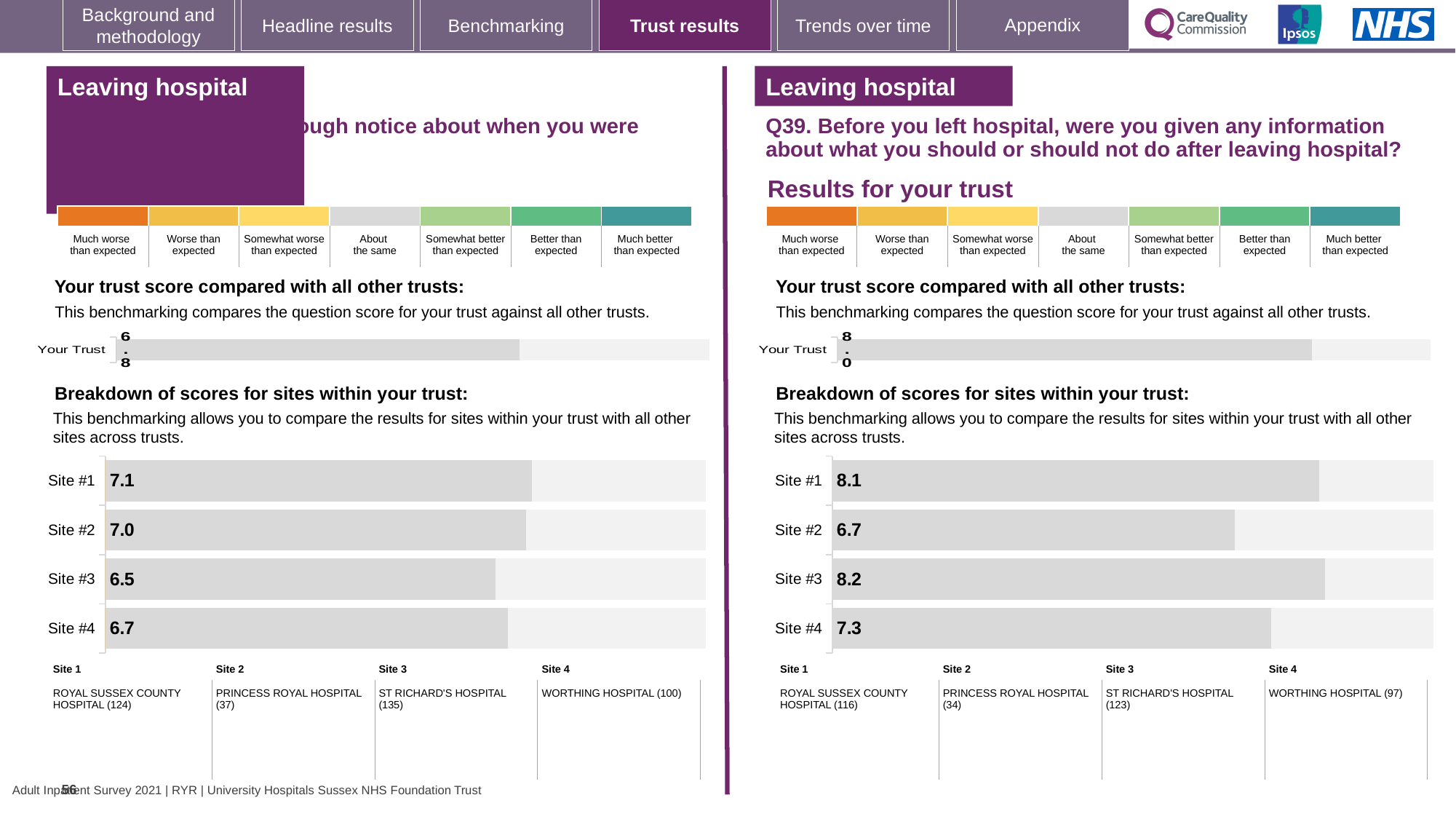
On the left-hand site breakdown chart, what is the score for Site #3? 6.5 On the left-hand site breakdown chart, which site has the highest score? Site #1 On the left-hand site breakdown chart, which is larger, the score for Site #2 or Site #4? Site #2 How many sites are shown on the right-hand (Q39) site breakdown chart? 4 On the right-hand (Q39) site breakdown chart, which site has the highest score? Site #3 On the right-hand (Q39) site breakdown chart, which site has the lowest score? Site #2 On the left-hand site breakdown chart, which site has the lowest score? Site #3 On the right-hand (Q39) site breakdown chart, what is the difference between the scores for Site #3 and Site #4? 0.9 On the right-hand (Q39) site breakdown chart, what is the score for Site #2? 6.7 On the right-hand (Q39) 'Your trust score compared with all other trusts' chart, what is the score for Your Trust? 8.0 On the right-hand (Q39) site breakdown chart, what is the score for Site #1? 8.1 On the left-hand 'Your trust score compared with all other trusts' chart, what is the score for Your Trust? 6.8